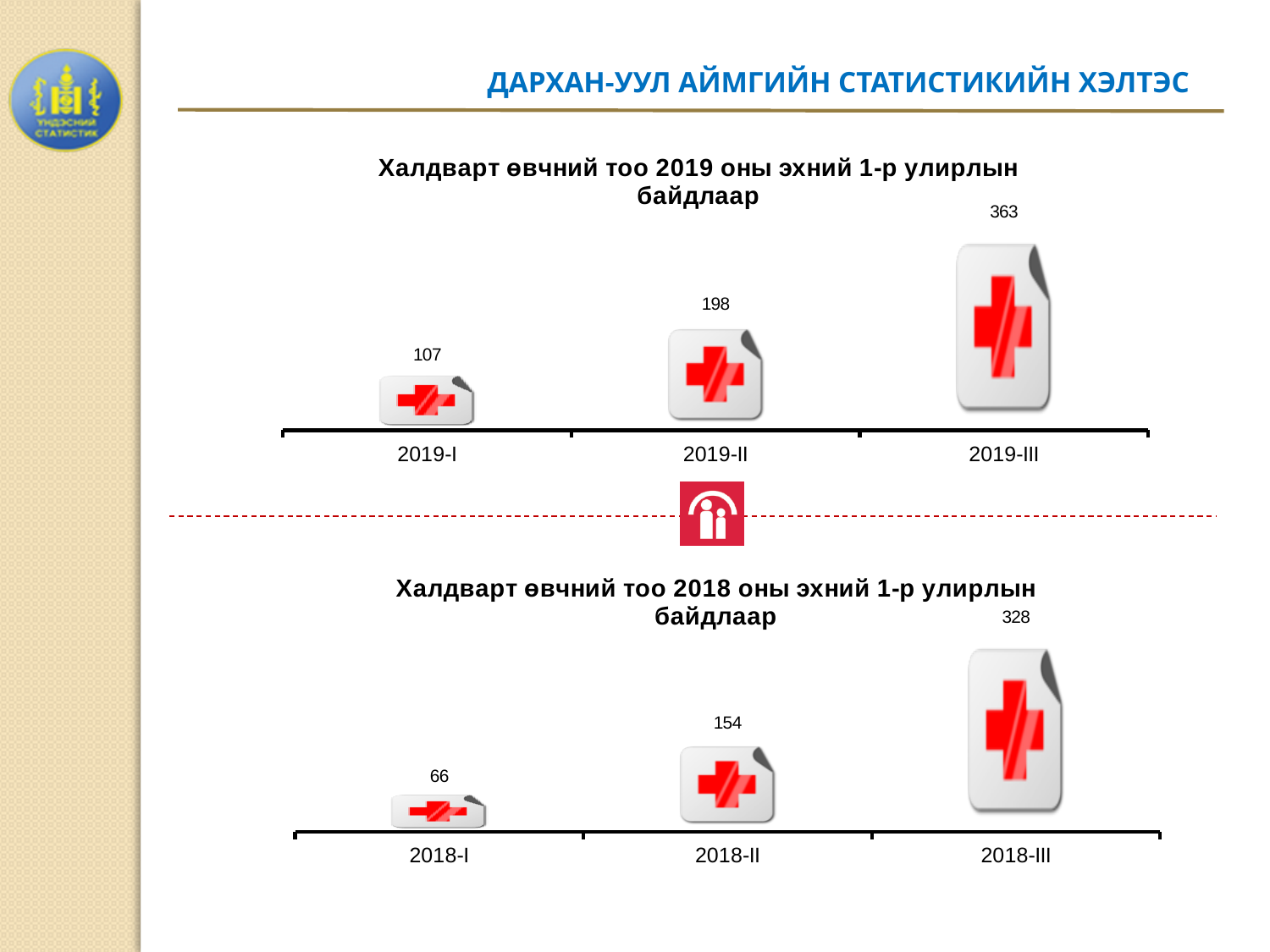
In the bottom chart (2018), do the values rise or fall from 2018-I to 2018-III? rise In the bottom chart (2018), what is the difference between the values for 2018-III and 2018-II? 174 In the top chart (2019), what is the value for 2019-III? 363 In the top chart (2019), what is the difference between the values for 2019-III and 2019-I? 256 In the top chart (2019), what is the value for 2019-II? 198 How many categories are shown in the bottom chart (2018)? 3 In the top chart (2019), which category has the highest value? 2019-III Which is larger: the value for 2019-I in the top chart or the value for 2018-I in the bottom chart? 2019-I In the bottom chart (2018), what is the value for 2018-I? 66 In the bottom chart (2018), which category has the lowest value? 2018-I In the bottom chart (2018), what is the value for 2018-II? 154 What kind of chart is the top chart (2019)? bar chart